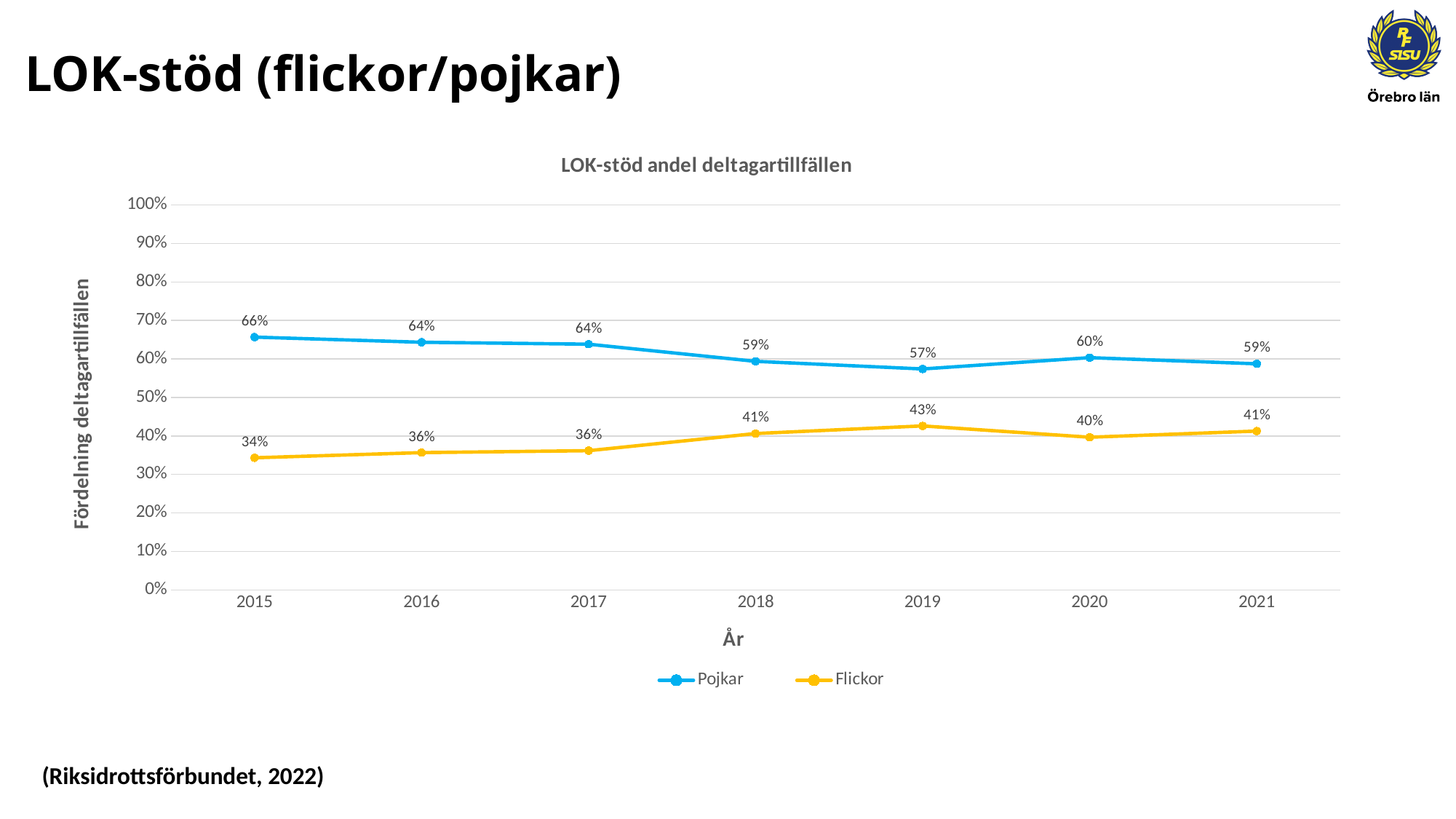
Does the Flickor series generally rise or fall from 2015 to 2021? Rise How many series does the legend list? 2 In which year is the Pojkar value lowest? 2019 What is the title of the chart? LOK-stöd andel deltagartillfällen What is the difference between the Pojkar and Flickor values in 2015? 32% What is the value for Flickor in 2021? 41% In which year is the Flickor value highest? 2019 What is the value for Flickor in 2019? 43% What is the value for Pojkar in 2015? 66% How many years are shown on the x axis? 7 What kind of chart is shown? Line chart Which is larger in 2020, the Pojkar value or the Flickor value? Pojkar